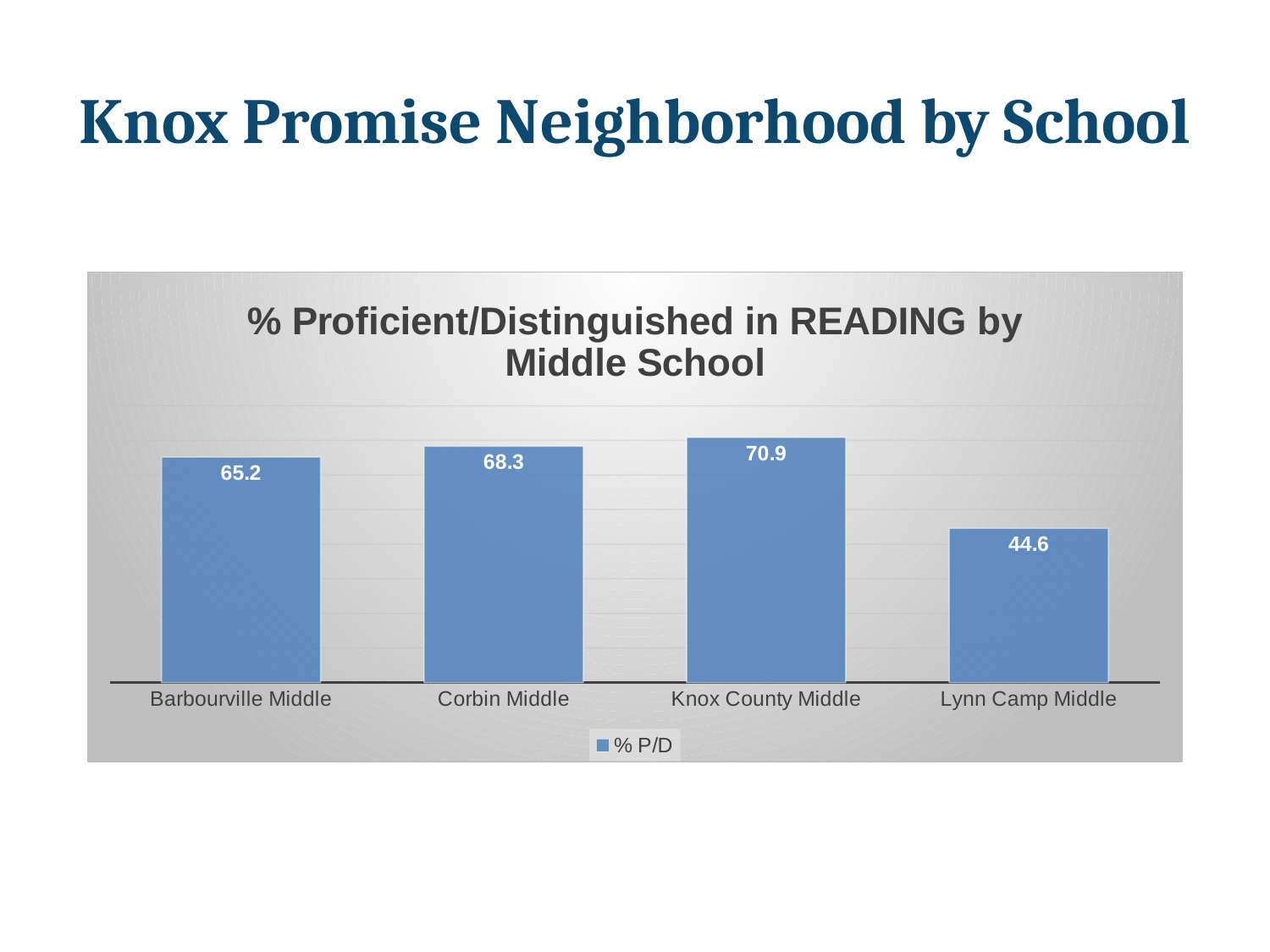
What is the % P/D value for Lynn Camp Middle? 44.6 What is the % P/D value for Knox County Middle? 70.9 What is the title of the chart? % Proficient/Distinguished in READING by Middle School What is the difference between the % P/D values for Corbin Middle and Barbourville Middle? 3.1 How many middle schools are shown in the chart? 4 What is the % P/D value for Barbourville Middle? 65.2 Which middle school has the highest % P/D value? Knox County Middle What type of chart is shown on the slide? Bar chart Which middle school has the lowest % P/D value? Lynn Camp Middle Which has a higher % P/D value, Barbourville Middle or Lynn Camp Middle? Barbourville Middle What is the % P/D value for Corbin Middle? 68.3 What is the difference between the % P/D values for Knox County Middle and Lynn Camp Middle? 26.3